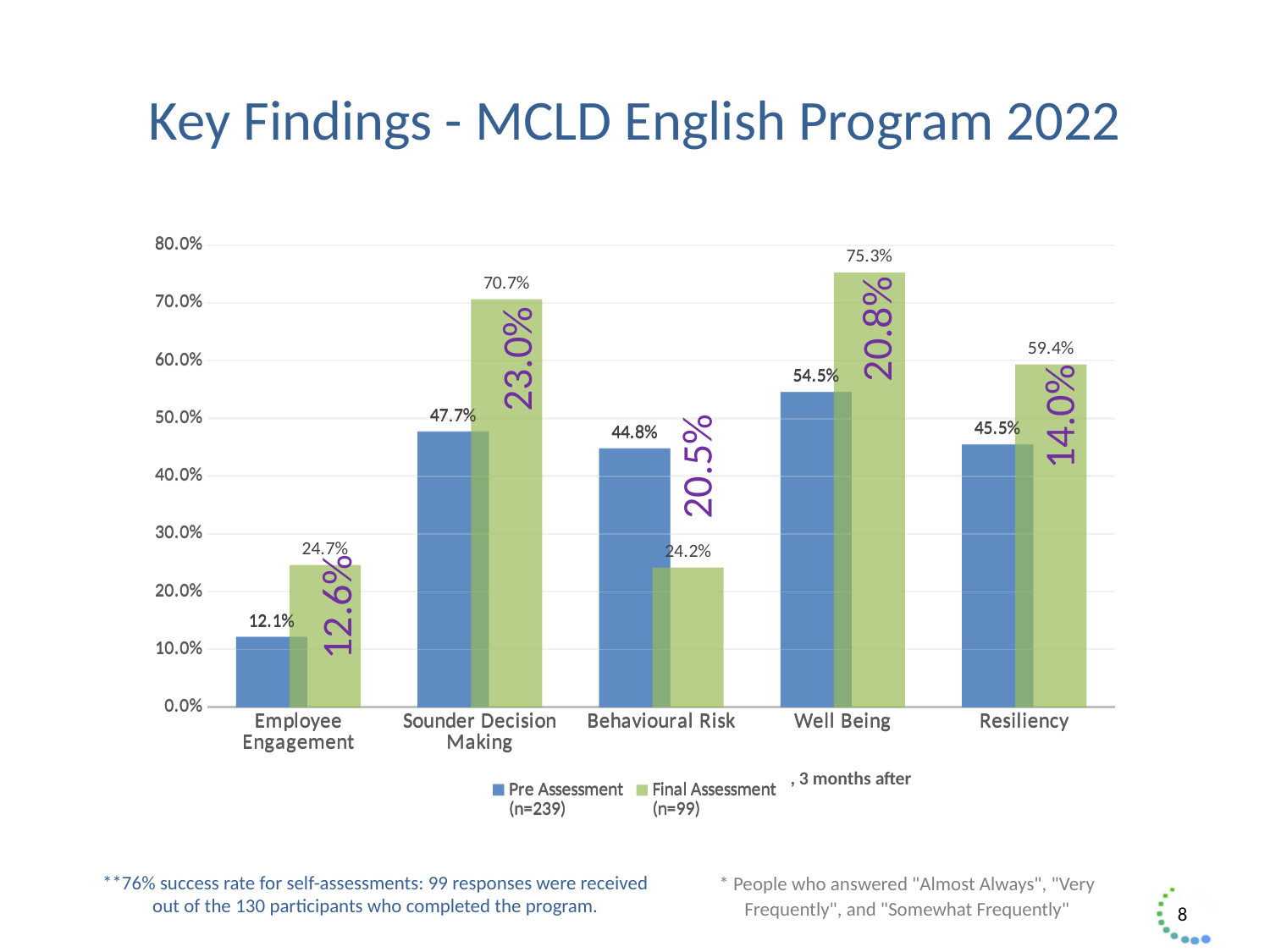
What is the Final Assessment value for Well Being? 75.3% How many series does the legend list? 2 What is the Pre Assessment value for Employee Engagement? 12.1% Is the Final Assessment value for Resiliency greater or less than 50.0%? greater Which is larger for Behavioural Risk, the Pre Assessment value or the Final Assessment value? Pre Assessment What kind of chart is shown on the slide? Bar chart Which category has the highest Final Assessment value? Well Being What is the difference between the Final Assessment and Pre Assessment values for Sounder Decision Making? 23.0% How many categories are shown on the x axis? 5 What is the Pre Assessment value for Resiliency? 45.5% Which category has the lowest Pre Assessment value? Employee Engagement What is the Final Assessment value for Behavioural Risk? 24.2%